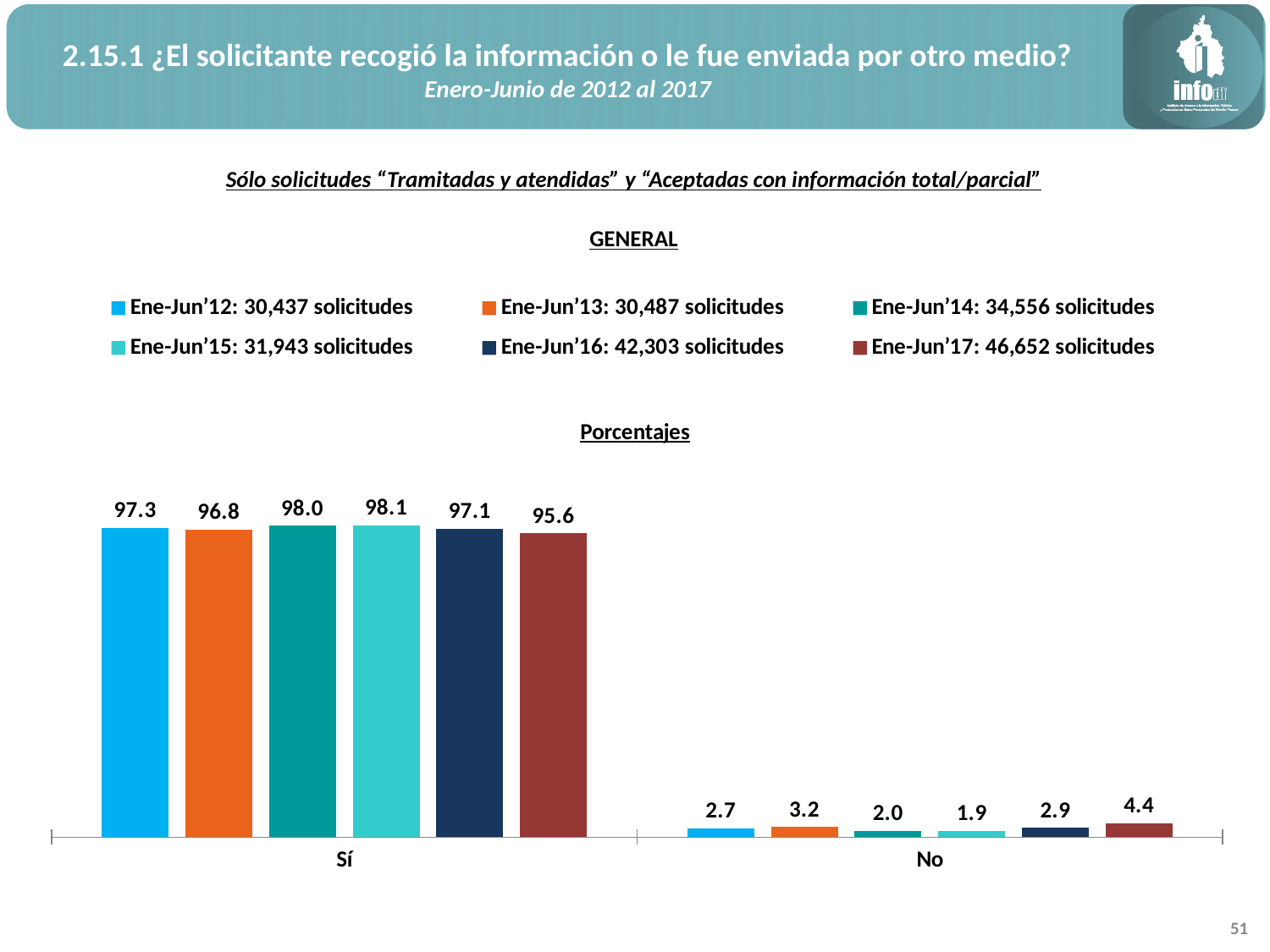
What is the value for Ene-Jun'15 in the Sí category? 98.1 Which is larger: the No value for Ene-Jun'13 or the No value for Ene-Jun'16? Ene-Jun'13 What is the difference between the No values for Ene-Jun'17 and Ene-Jun'12? 1.7 What is the difference between the Sí values for Ene-Jun'15 and Ene-Jun'17? 2.5 How many categories are shown on the x axis? 2 What is the value for Ene-Jun'12 in the Sí category? 97.3 Which series has the lowest value in the No category? Ene-Jun'15 How many series does the legend list? 6 According to the legend, how many solicitudes does Ene-Jun'17 correspond to? 46,652 solicitudes What is the value for Ene-Jun'17 in the No category? 4.4 Which series has the highest value in the Sí category? Ene-Jun'15 What kind of chart is shown on the slide? Bar chart